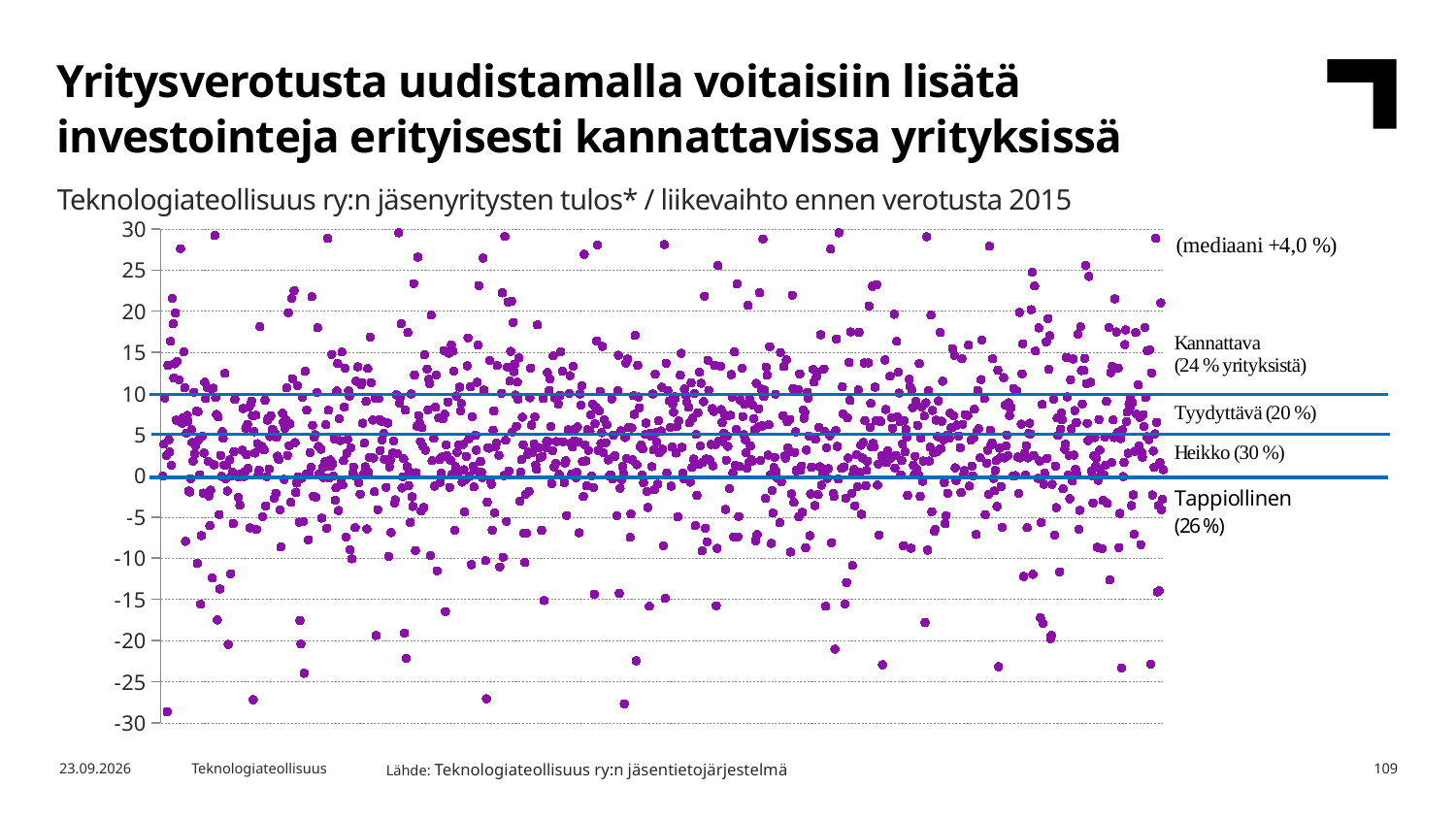
Which group has a larger share of companies, Kannattava or Tappiollinen? Tappiollinen Which of the four labelled groups (Kannattava, Tyydyttävä, Heikko, Tappiollinen) has the largest share of companies? Heikko At which vertical-axis values are the three horizontal blue reference lines drawn on the chart? 10, 5 and 0 What share of companies is labelled Tyydyttävä on the chart? 20 % What are the minimum and maximum values shown on the vertical axis of the chart? -30 and 30 What share of companies is labelled Tappiollinen on the chart? 26 % What kind of chart is shown on the slide? Scatter chart What is the median value of tulos / liikevaihto stated on the chart? +4,0 % What share of companies is labelled Kannattava on the chart? 24 % Which of the four labelled groups (Kannattava, Tyydyttävä, Heikko, Tappiollinen) has the smallest share of companies? Tyydyttävä What share of companies is labelled Heikko on the chart? 30 % How many percentage points larger is the Heikko share than the Tyydyttävä share? 10